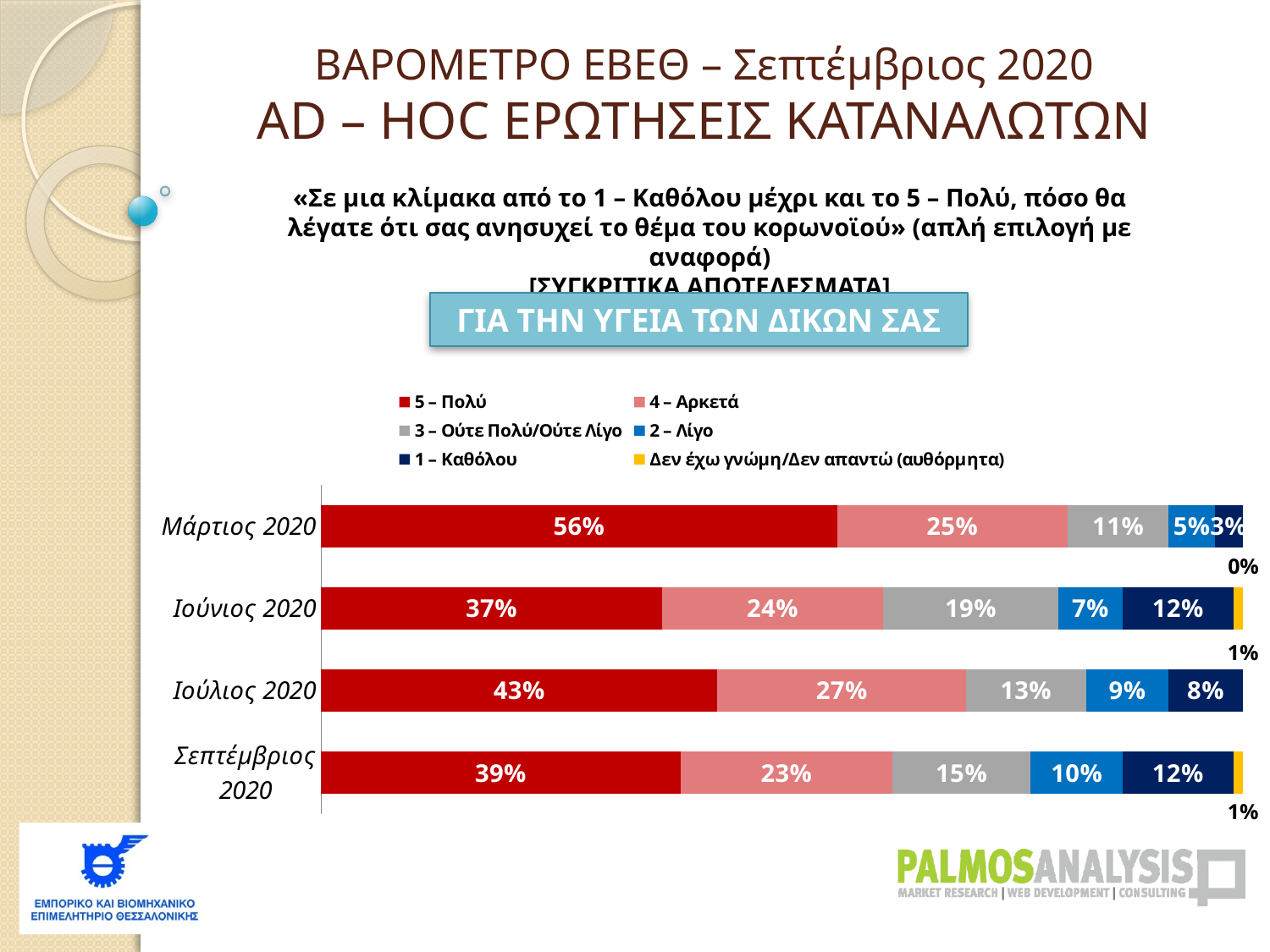
How many series does the legend list? 6 Which period has the highest value for "5 – Πολύ"? Μάρτιος 2020 How many time periods (categories) are plotted on the chart? 4 Which period has the lowest value for "5 – Πολύ"? Ιούνιος 2020 What is the value of "5 – Πολύ" for Μάρτιος 2020? 56% What is the value of "1 – Καθόλου" for Ιούνιος 2020? 12% What kind of chart is shown on the slide? stacked bar chart Which colour represents the "1 – Καθόλου" series in the legend? dark blue What is the difference between the "5 – Πολύ" values for Μάρτιος 2020 and Σεπτέμβριος 2020? 17 percentage points What is the value of "4 – Αρκετά" for Ιούλιος 2020? 27% What is the value of "3 – Ούτε Πολύ/Ούτε Λίγο" for Σεπτέμβριος 2020? 15% Which is larger: the "2 – Λίγο" value for Ιούλιος 2020 or for Ιούνιος 2020? Ιούλιος 2020